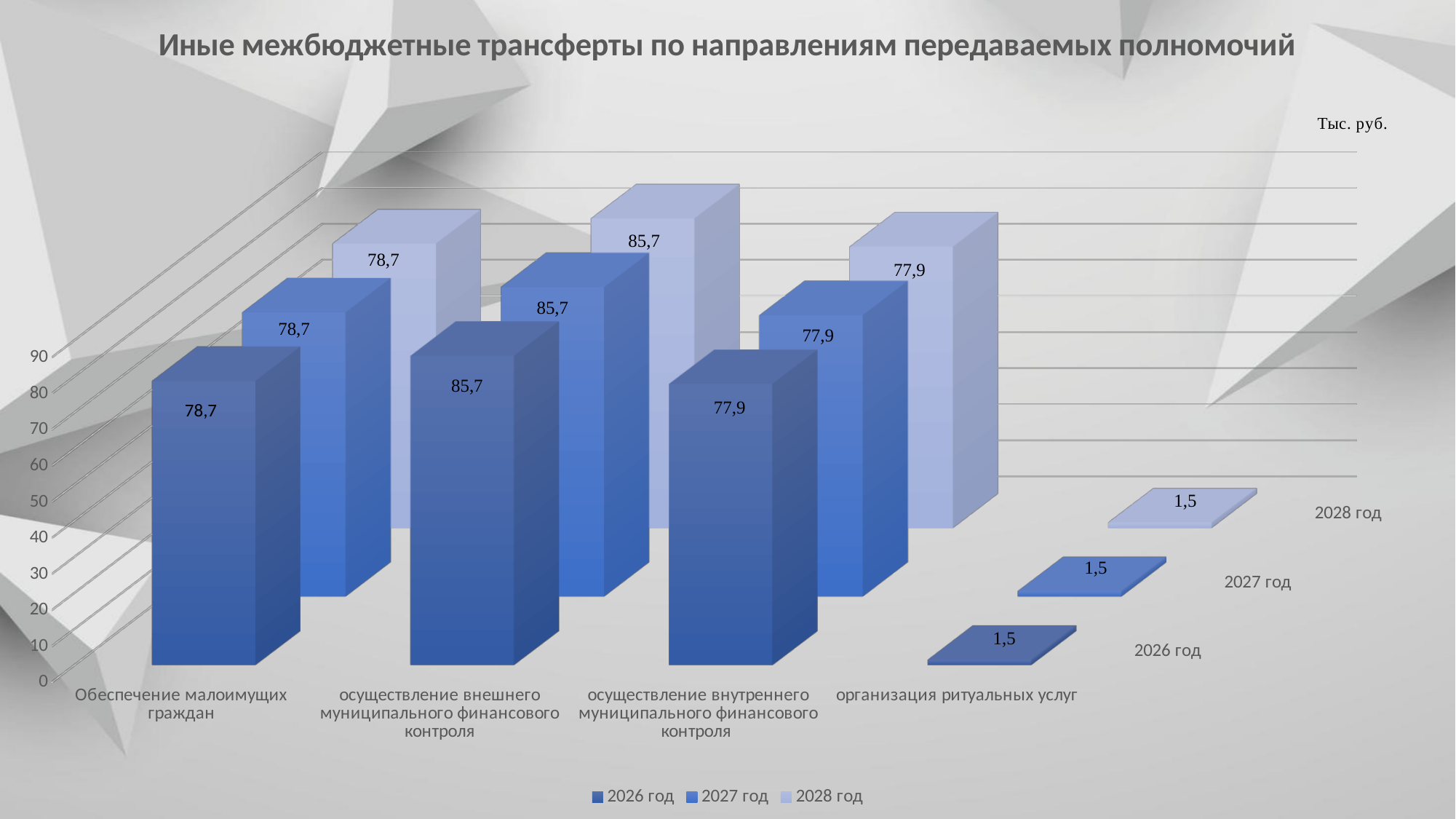
Which category has the lowest value in the 2028 год series? организация ритуальных услуг How many series does the legend list? 3 What unit is indicated for the values on the chart? Тыс. руб. What is the value for "Обеспечение малоимущих граждан" in the 2026 год series? 78,7 What kind of chart is shown on the slide? bar chart What is the value for "осуществление внутреннего муниципального финансового контроля" in the 2027 год series? 77,9 In the 2027 год series, which is larger: "Обеспечение малоимущих граждан" or "осуществление внутреннего муниципального финансового контроля"? Обеспечение малоимущих граждан What is the value for "осуществление внешнего муниципального финансового контроля" in the 2028 год series? 85,7 What is the difference between the 2026 год values for "осуществление внешнего муниципального финансового контроля" and "Обеспечение малоимущих граждан"? 7,0 Which category has the highest value in the 2026 год series? осуществление внешнего муниципального финансового контроля What is the value for "организация ритуальных услуг" in the 2027 год series? 1,5 How many categories are shown on the x axis? 4